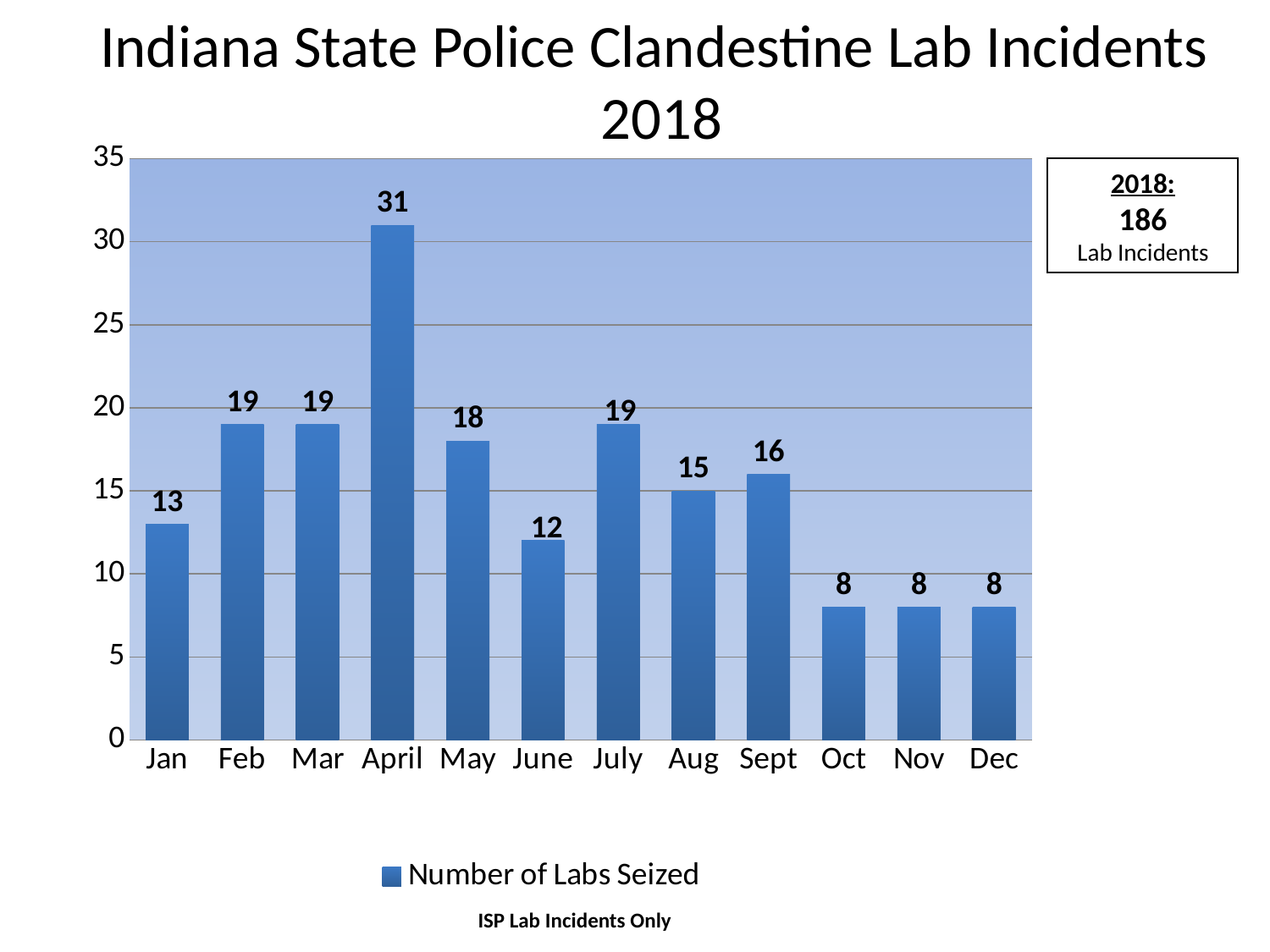
What is the number of labs seized in September? 16 Which month has more labs seized, May or August? May Is the value for February greater or less than 15? greater How many series does the legend list? 1 What is the number of labs seized in January? 13 What is the number of labs seized in April? 31 How many months are shown on the x axis? 12 What is the title of the chart? Indiana State Police Clandestine Lab Incidents 2018 What is the lowest value shown on the chart? 8 What kind of chart is shown on the slide? Bar chart What is the difference between the number of labs seized in April and in June? 19 Which month has the highest number of labs seized? April